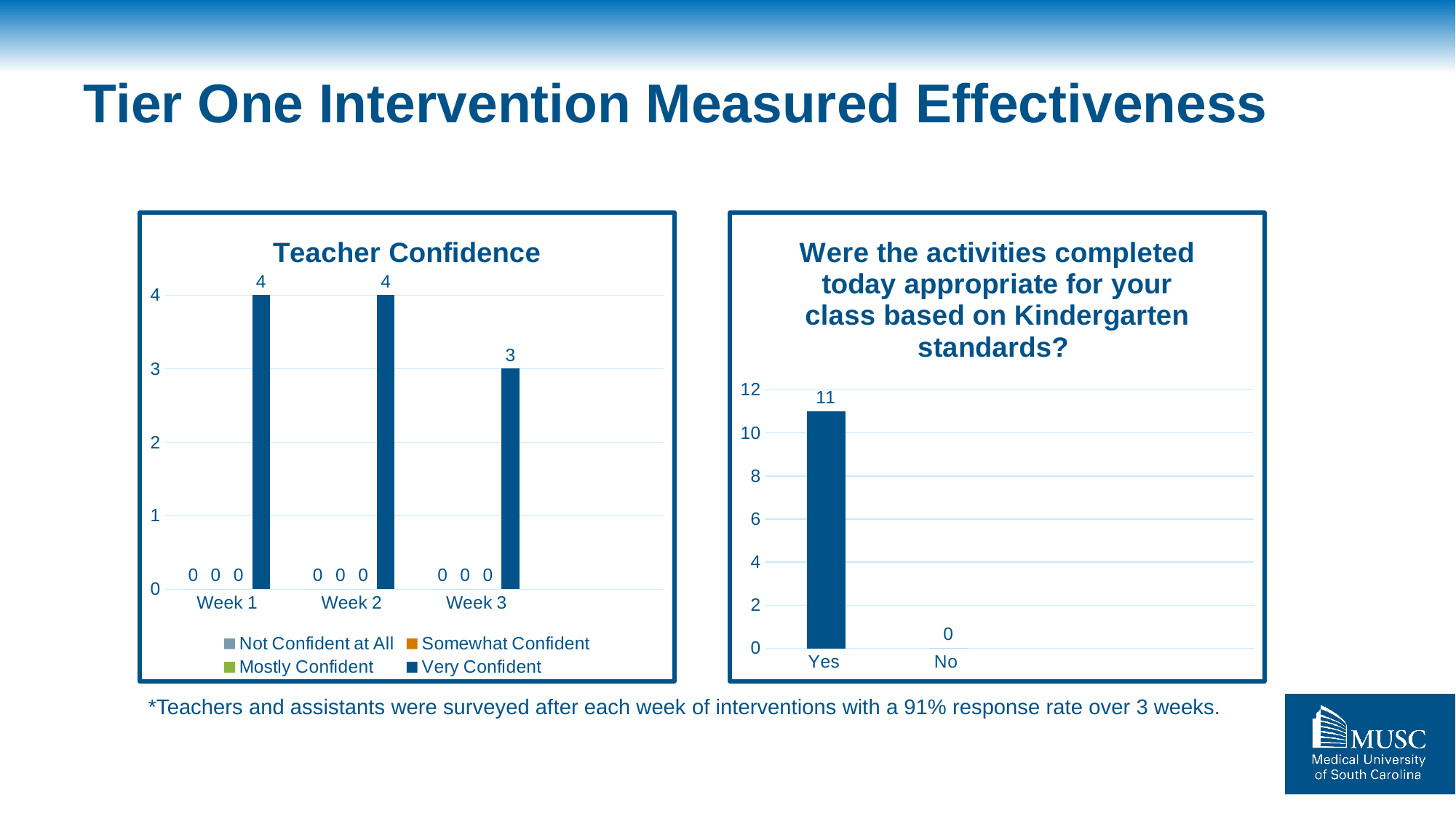
In the Teacher Confidence chart, how many series does the legend list? 4 In the Teacher Confidence chart, how many weeks are shown on the x axis? 3 In the chart on the right, what is the difference between the Yes and No values? 11 In the Teacher Confidence chart, what is the value for Very Confident in Week 3? 3 In the chart on the right, what is the value for Yes? 11 In the Teacher Confidence chart, what is the difference between the Very Confident values for Week 1 and Week 3? 1 In the Teacher Confidence chart, which week has the lowest Very Confident value? Week 3 In the chart on the right, what is the value for No? 0 In the Teacher Confidence chart, what is the value for Very Confident in Week 1? 4 In the chart on the right, which category is higher, Yes or No? Yes What kind of chart is the Teacher Confidence chart? Bar chart In the Teacher Confidence chart, what is the value for Not Confident at All in Week 2? 0